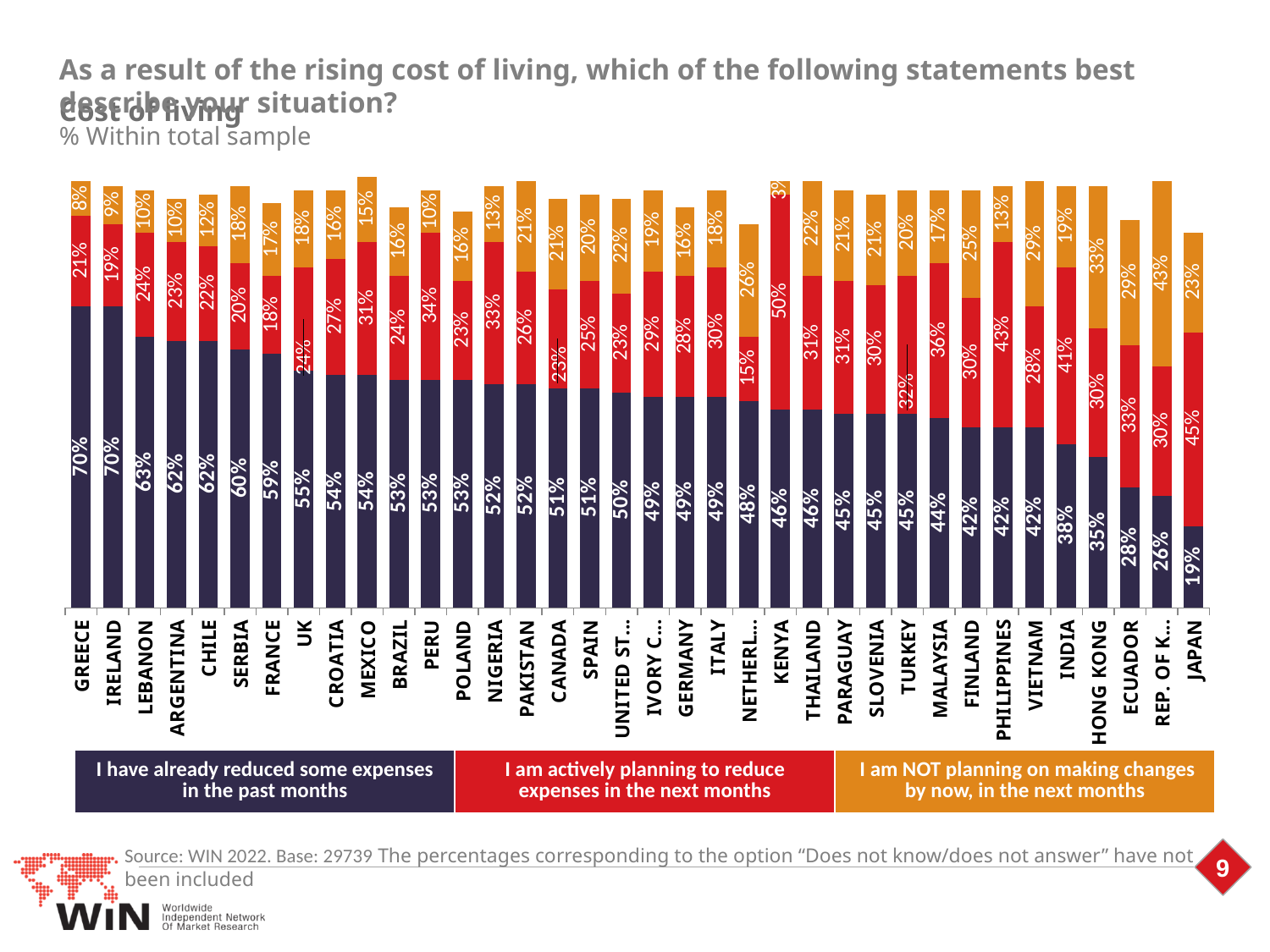
Which country has the lowest share of respondents who have already reduced some expenses in the past months? Japan What percentage of respondents in Kenya said they are actively planning to reduce expenses in the next months? 50% Which country has the highest share of respondents who are NOT planning on making changes by now, in the next months? Rep. of K... What is the difference between the share of respondents in Mexico and in Peru who are actively planning to reduce expenses in the next months? 3% Which has a larger share of respondents who have already reduced some expenses: Serbia or Vietnam? Serbia What percentage of respondents in Greece said they have already reduced some expenses in the past months? 70% How many countries are shown on the x axis? 36 What kind of chart is shown on the slide? Stacked bar chart How many series does the legend list? 3 What percentage of respondents in Japan said they are NOT planning on making changes by now, in the next months? 23% What is the total of the three segments for the Greece bar? 99% Which country has the lowest share of respondents who are NOT planning on making changes by now, in the next months? Kenya